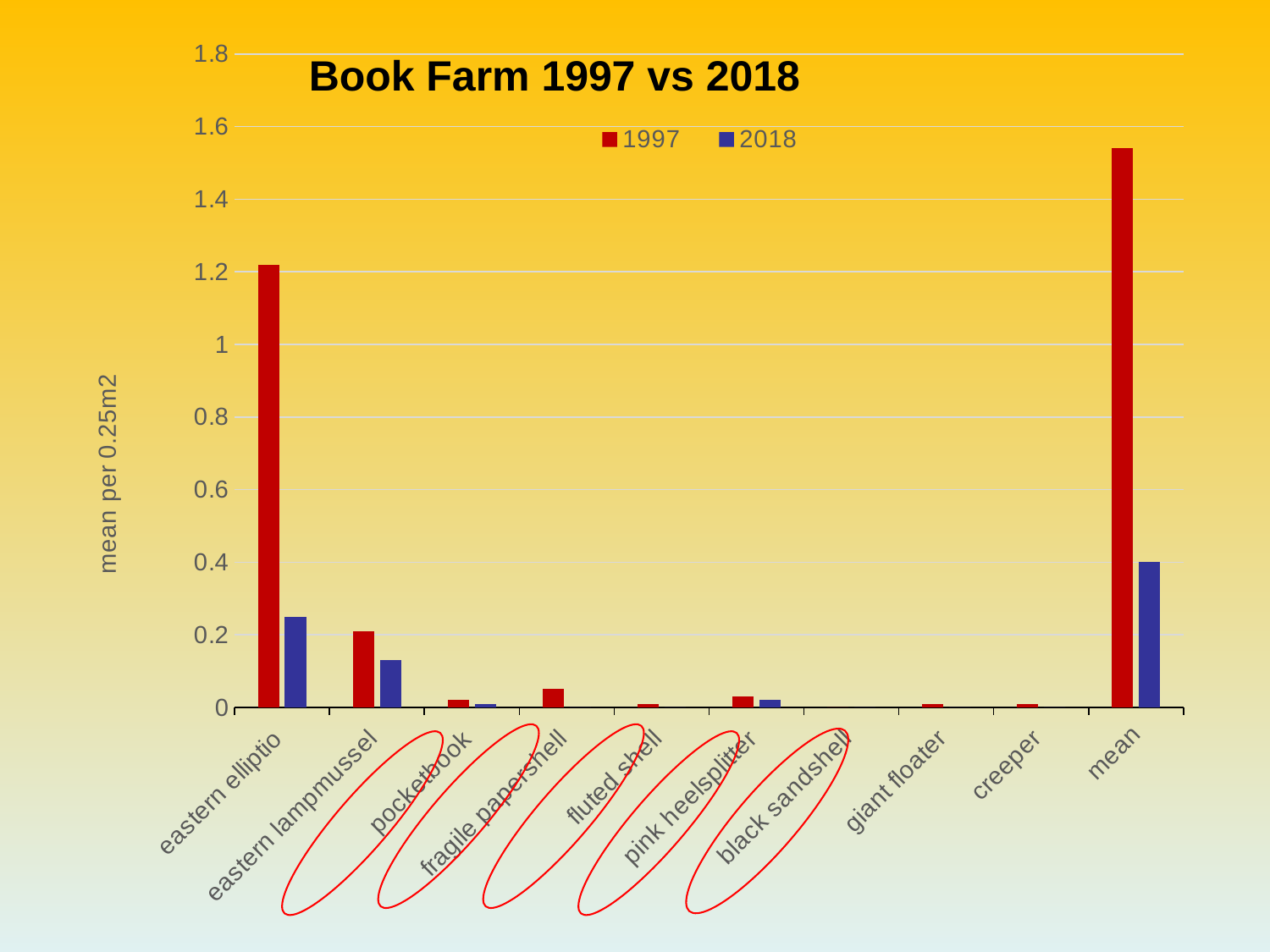
Is the 2018 value for mean greater or less than 0.6? less Is the 2018 value for eastern elliptio greater or less than 0.4? less Is the 1997 value for mean greater or less than 1.4? greater What is the title of the chart? Book Farm 1997 vs 2018 How many series does the legend list? 2 How many categories are shown along the x axis? 10 What is the label on the y axis? mean per 0.25m2 What kind of chart is shown on the slide? bar chart Which category has the highest 1997 value? mean For eastern elliptio, which series has the larger value, 1997 or 2018? 1997 Which category has the highest 2018 value? mean